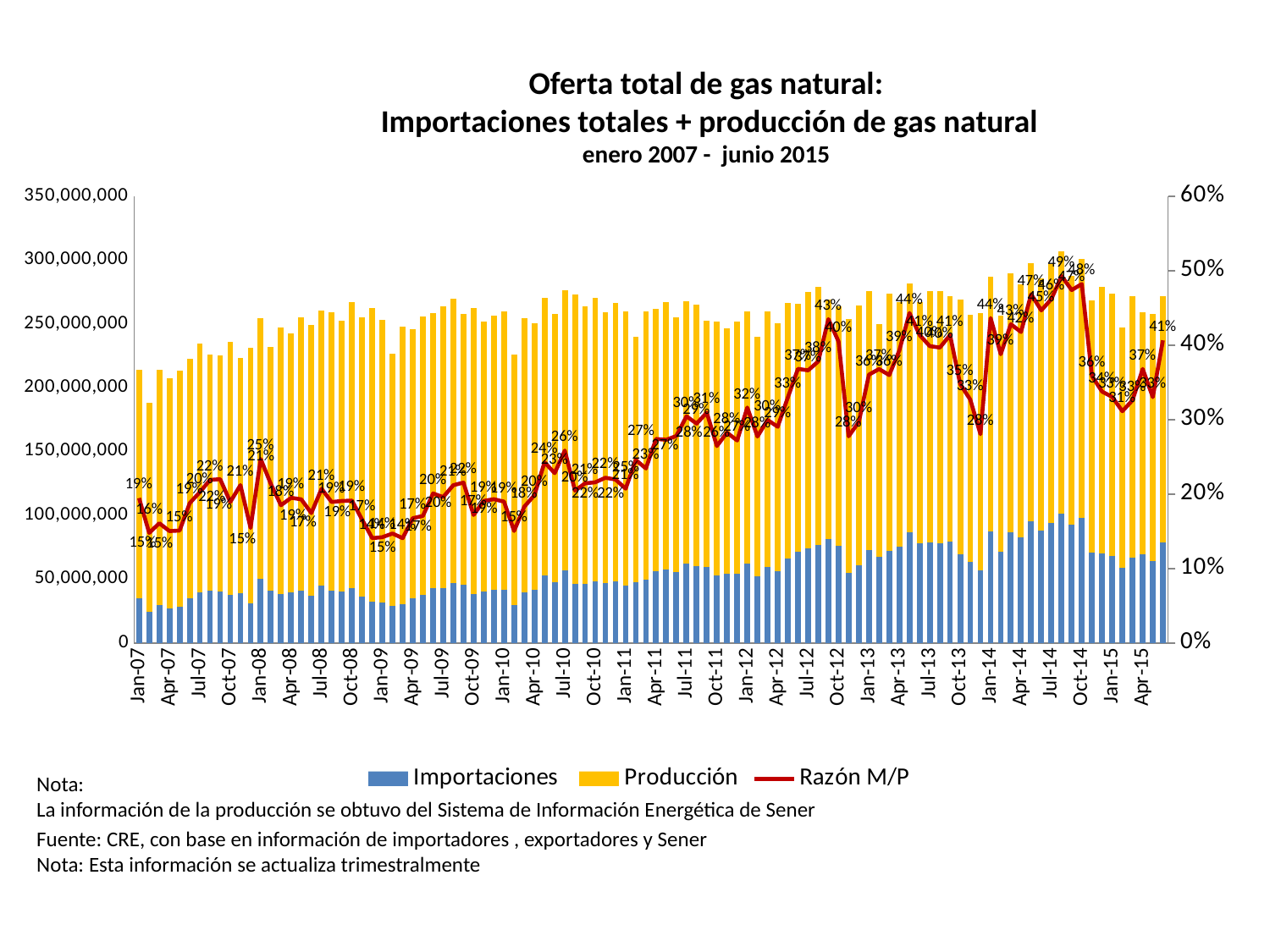
What is the highest value labelled on the Razón M/P line? 49% Which is larger, the Razón M/P value at Jan-07 or at the last point in June 2015? June 2015 What are the three series named in the legend? Importaciones, Producción, Razón M/P Is the Importaciones value for Jan-07 greater or less than 50,000,000? less What is the lowest value labelled on the Razón M/P line? 14% What is the Razón M/P value labelled at the first point, Jan-07? 19% Does the Razón M/P line generally rise or fall from 2007 to 2015? rise Is the total stacked bar (Importaciones + Producción) for Jan-07 greater or less than 200,000,000? greater What is the difference between the Razón M/P value at the last point (41%) and at Jan-07 (19%)? 22 percentage points How many series does the legend list? 3 What is the Razón M/P value labelled at the last point of the series (June 2015)? 41% What kind of chart is this? Combination stacked bar and line chart